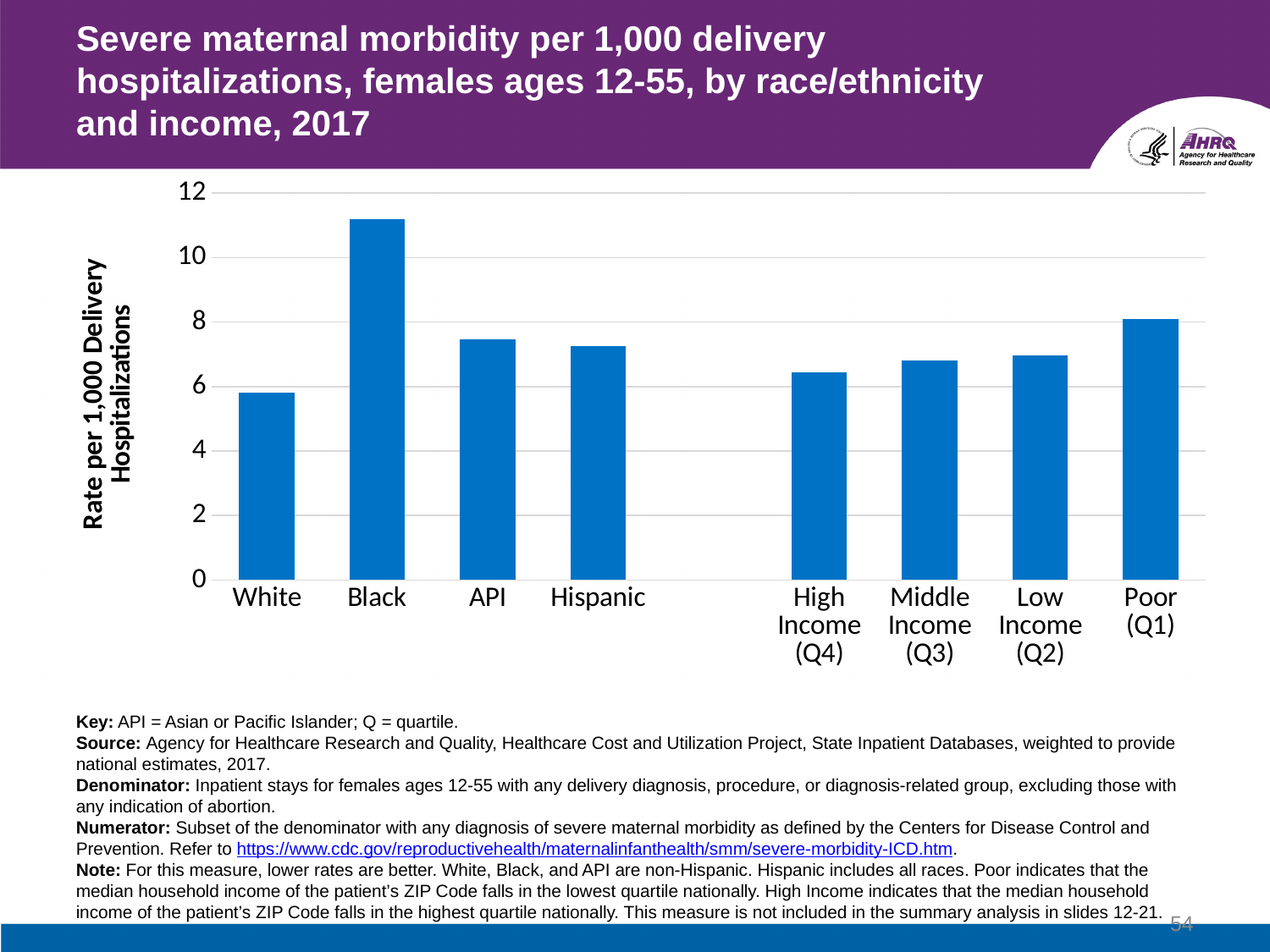
Is the value for Black greater or less than 10? greater Across the income categories from High Income (Q4) to Poor (Q1), do the values rise or fall? rise Which category has the highest severe maternal morbidity rate? Black Which is larger, the value for Poor (Q1) or the value for High Income (Q4)? Poor (Q1) Which category has the lowest severe maternal morbidity rate? White How many categories are plotted on the chart? 8 Is the value for White greater or less than 6? less Which is larger, the value for Black or the value for Hispanic? Black What kind of chart is shown on the slide? bar chart Is the value for High Income (Q4) greater or less than 8? less What is the label on the vertical axis of the chart? Rate per 1,000 Delivery Hospitalizations